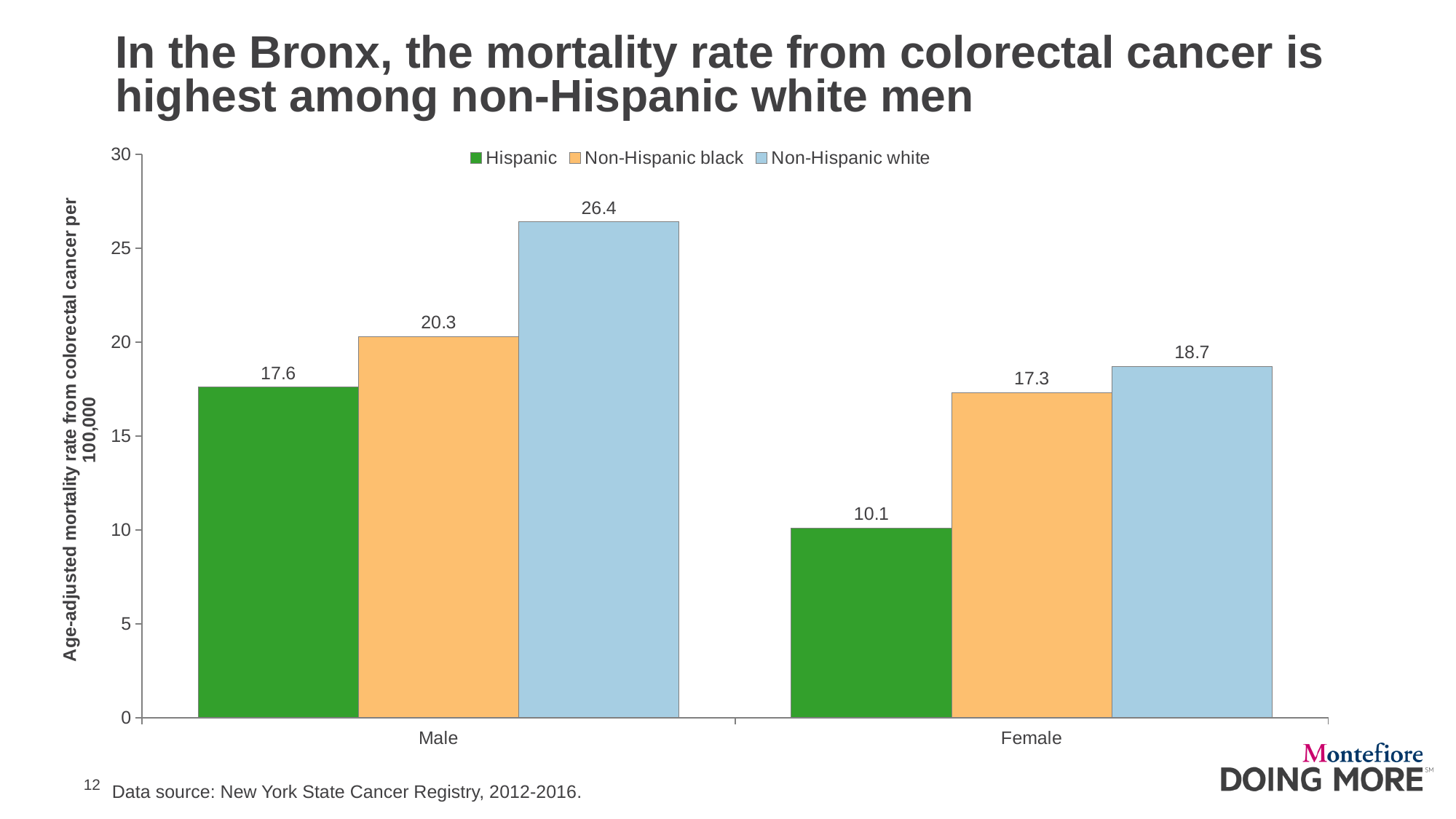
What colour represents the Hispanic series in the chart? Green Is the mortality rate for Non-Hispanic white females greater or less than 20? less Which group has the lowest colorectal cancer mortality rate on the chart? Hispanic females What is the colorectal cancer mortality rate for Non-Hispanic white males? 26.4 What kind of chart is shown on the slide? Bar chart What is the difference between the mortality rates for Non-Hispanic white males and Non-Hispanic white females? 7.7 What is the difference between the mortality rates for Hispanic males and Hispanic females? 7.5 Which is larger, the mortality rate for Non-Hispanic black females or for Hispanic males? Hispanic males How many series does the legend list? 3 Which group has the highest colorectal cancer mortality rate on the chart? Non-Hispanic white males What is the colorectal cancer mortality rate for Non-Hispanic black males? 20.3 What is the colorectal cancer mortality rate for Hispanic females? 10.1